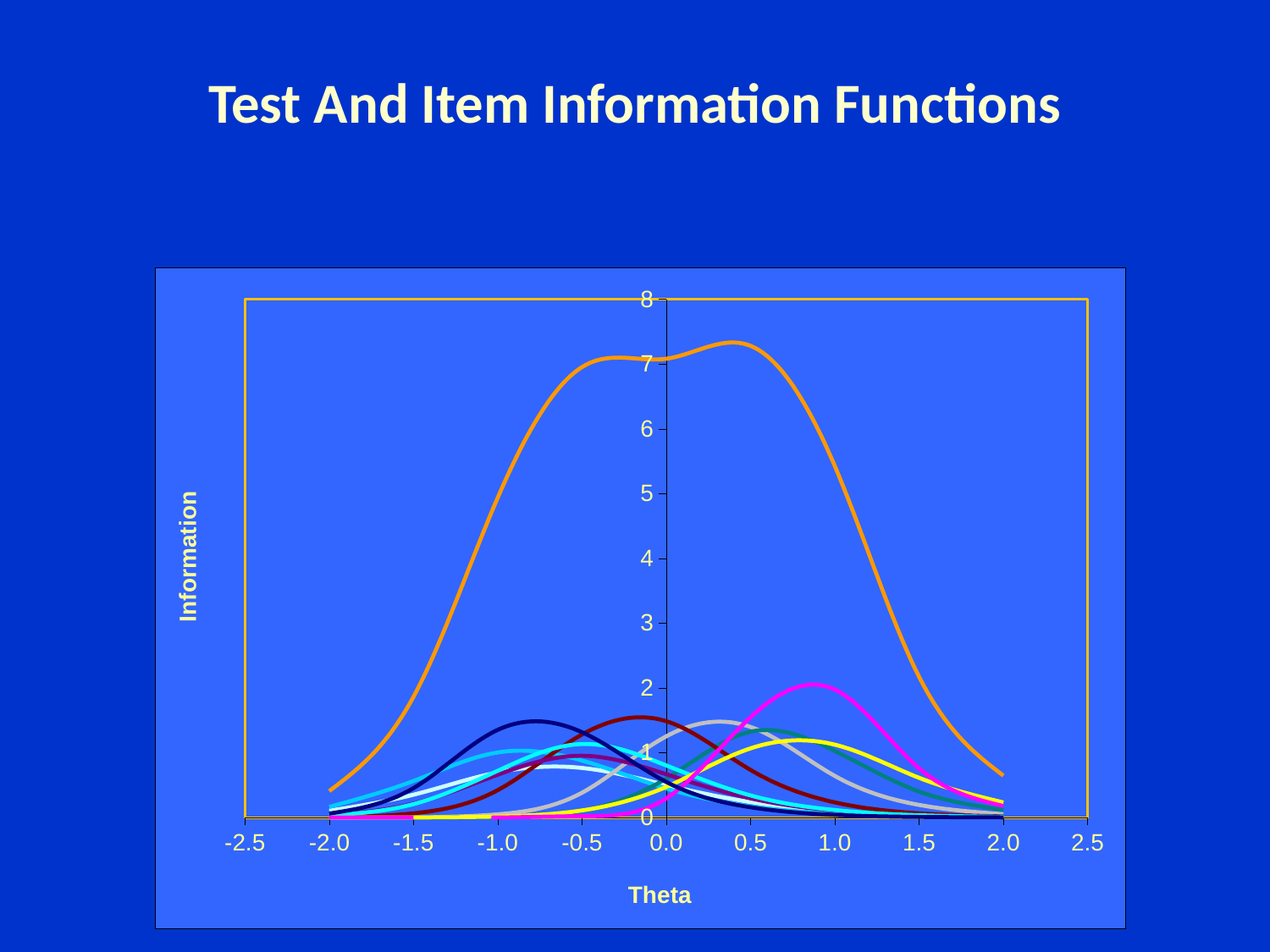
What is the title of the chart on the slide? Test And Item Information Functions Does the tallest (orange) line rise or fall as Theta goes from -2.0 to 0.0? rise Is the peak value of the tallest (orange) line greater or less than 7? greater What kind of chart is shown on the slide? line chart Is the value of the tallest (orange) line at Theta 0.0 greater or less than 6? greater Is the value of the tallest (orange) line at Theta -2.0 greater or less than 2? less What is the label on the horizontal axis of the chart? Theta Does the tallest (orange) line rise or fall as Theta goes from 0.5 to 2.0? fall Which line reaches a higher peak, the orange line or the magenta line? the orange line